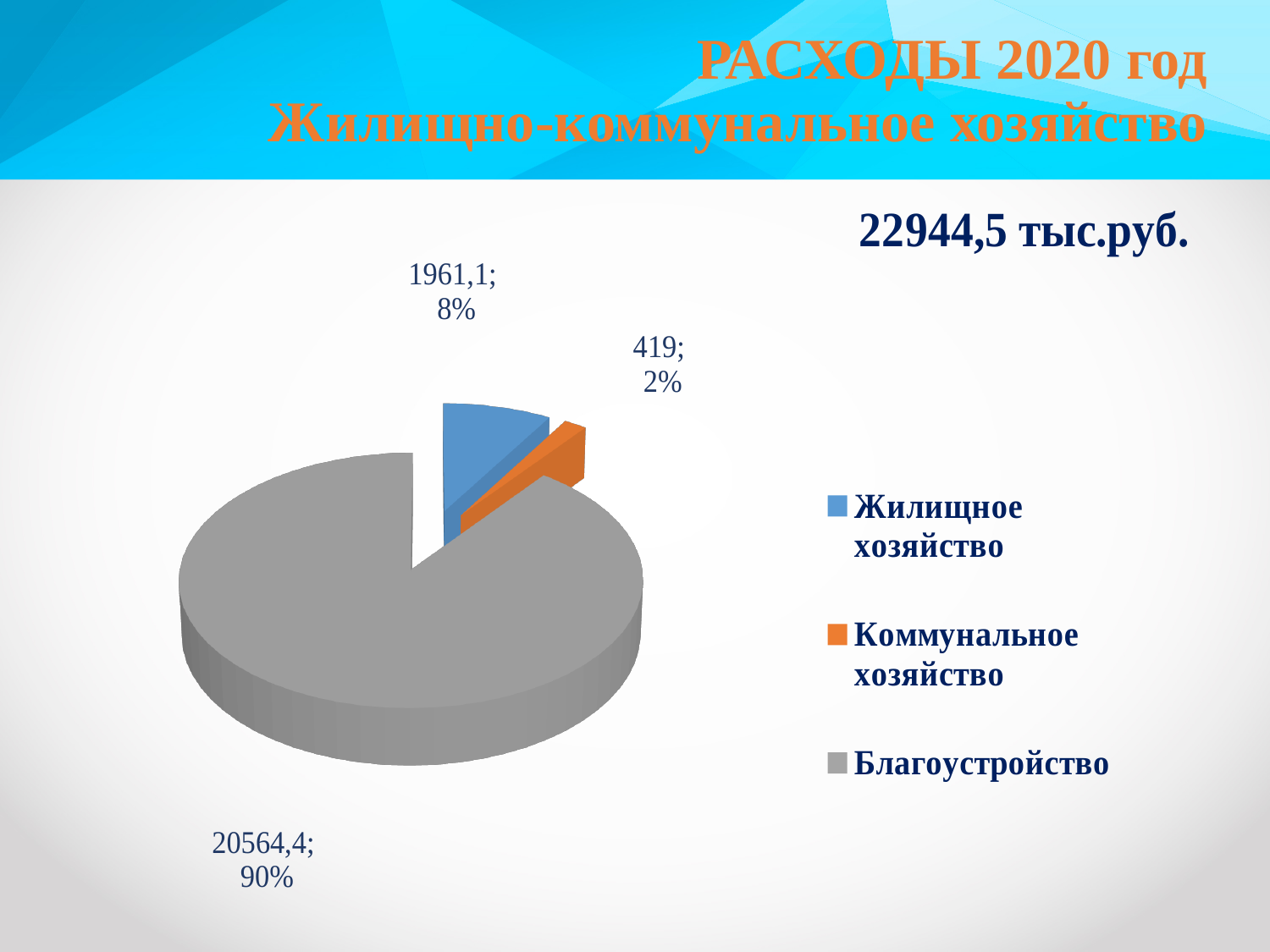
Which colour represents Коммунальное хозяйство in the legend? Orange What is the value for Благоустройство? 20564,4 How many slices does the pie chart have? 3 Which category has the smallest slice? Коммунальное хозяйство Which category has the largest slice? Благоустройство What is the value for Жилищное хозяйство? 1961,1 What is the value for Коммунальное хозяйство? 419 What share of the pie does Жилищное хозяйство take? 8% Which is larger, Жилищное хозяйство or Коммунальное хозяйство? Жилищное хозяйство What share of the pie does Благоустройство take? 90% What is the difference between the values for Жилищное хозяйство and Коммунальное хозяйство? 1542,1 What kind of chart is shown on the slide? Pie chart